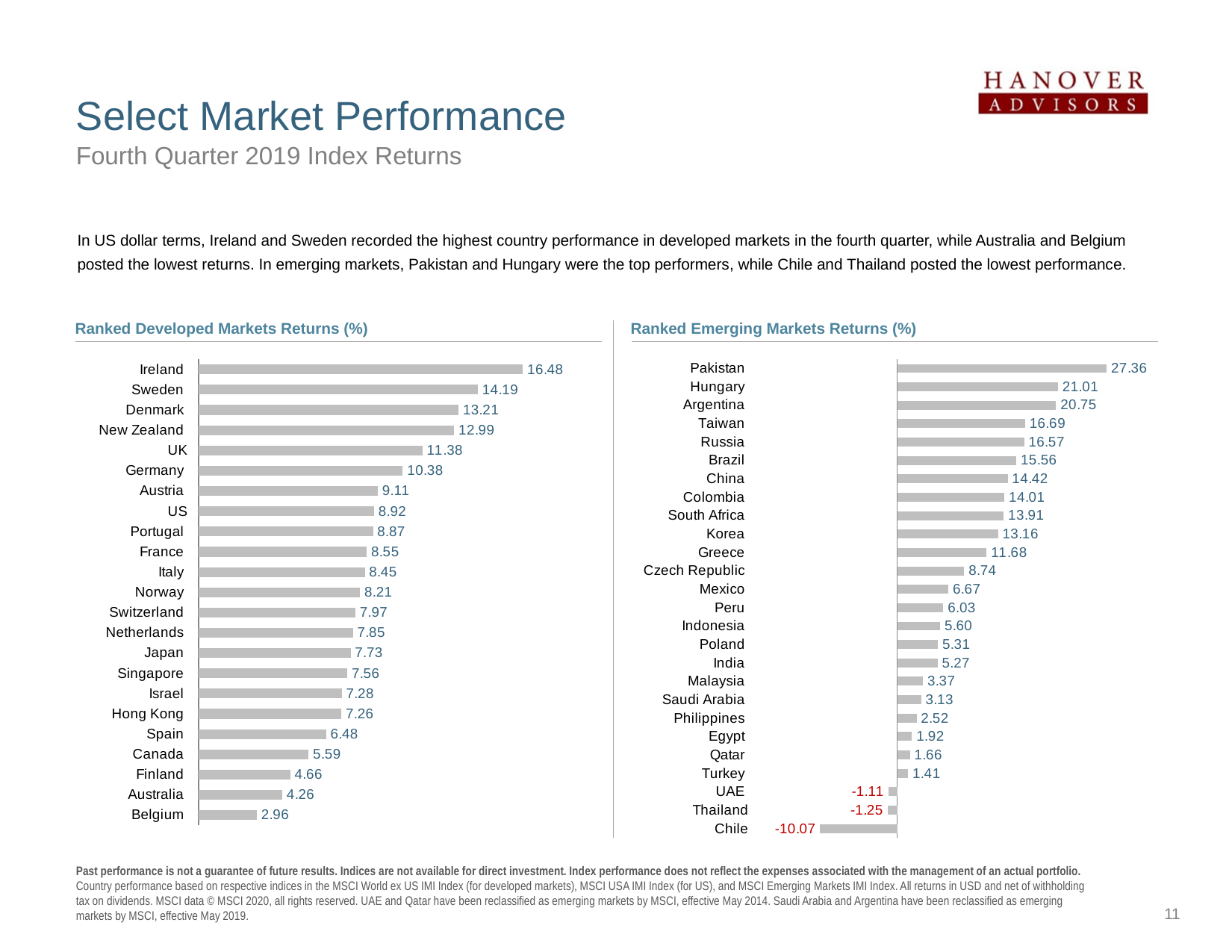
In the Ranked Developed Markets Returns (%) chart, what is the value for Germany? 10.38 In the Ranked Emerging Markets Returns (%) chart, which country has the highest return? Pakistan In the Ranked Emerging Markets Returns (%) chart, what is the difference between the values for Pakistan and Hungary? 6.35 How many countries are shown in the Ranked Developed Markets Returns (%) chart? 23 In the Ranked Developed Markets Returns (%) chart, which country has the lowest return? Belgium How many countries are shown in the Ranked Emerging Markets Returns (%) chart? 26 In the Ranked Emerging Markets Returns (%) chart, what is the value for Chile? -10.07 In the Ranked Emerging Markets Returns (%) chart, which is larger, the value for Taiwan or the value for Brazil? Taiwan In the Ranked Emerging Markets Returns (%) chart, how many countries have negative returns? 3 In the Ranked Developed Markets Returns (%) chart, what is the difference between the values for Ireland and Sweden? 2.29 What kind of chart is the Ranked Emerging Markets Returns (%) chart? Bar chart In the Ranked Developed Markets Returns (%) chart, which country has the highest return? Ireland